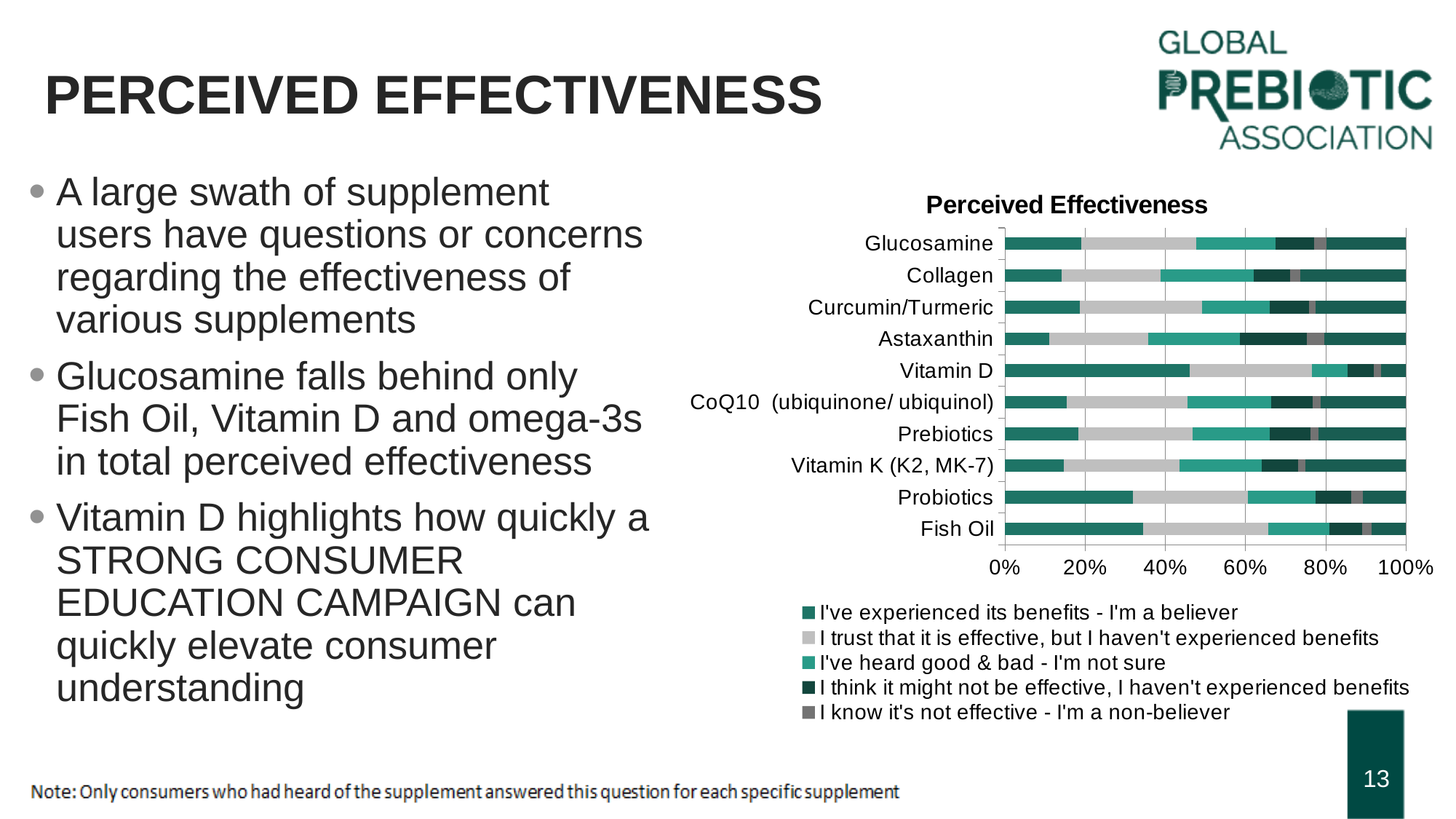
What do the stacked segments of each bar in the Perceived Effectiveness chart add up to? 100% What is the first entry in the chart's legend? I've experienced its benefits - I'm a believer Is the 'I've experienced its benefits - I'm a believer' value for Fish Oil greater or less than 40%? less What is the title of the chart on the slide? Perceived Effectiveness Is the 'I've experienced its benefits - I'm a believer' value for Astaxanthin greater or less than 20%? less What kind of chart is shown on the slide? Stacked bar chart Is the 'I've experienced its benefits - I'm a believer' value for Vitamin D greater or less than 40%? greater Which supplement has the smallest 'I've experienced its benefits - I'm a believer' segment? Astaxanthin Which has the larger 'I've experienced its benefits - I'm a believer' segment, Probiotics or Collagen? Probiotics How many supplements are listed on the y axis of the Perceived Effectiveness chart? 10 Which supplement has the largest 'I've experienced its benefits - I'm a believer' segment? Vitamin D How many series does the legend of the Perceived Effectiveness chart list? 5